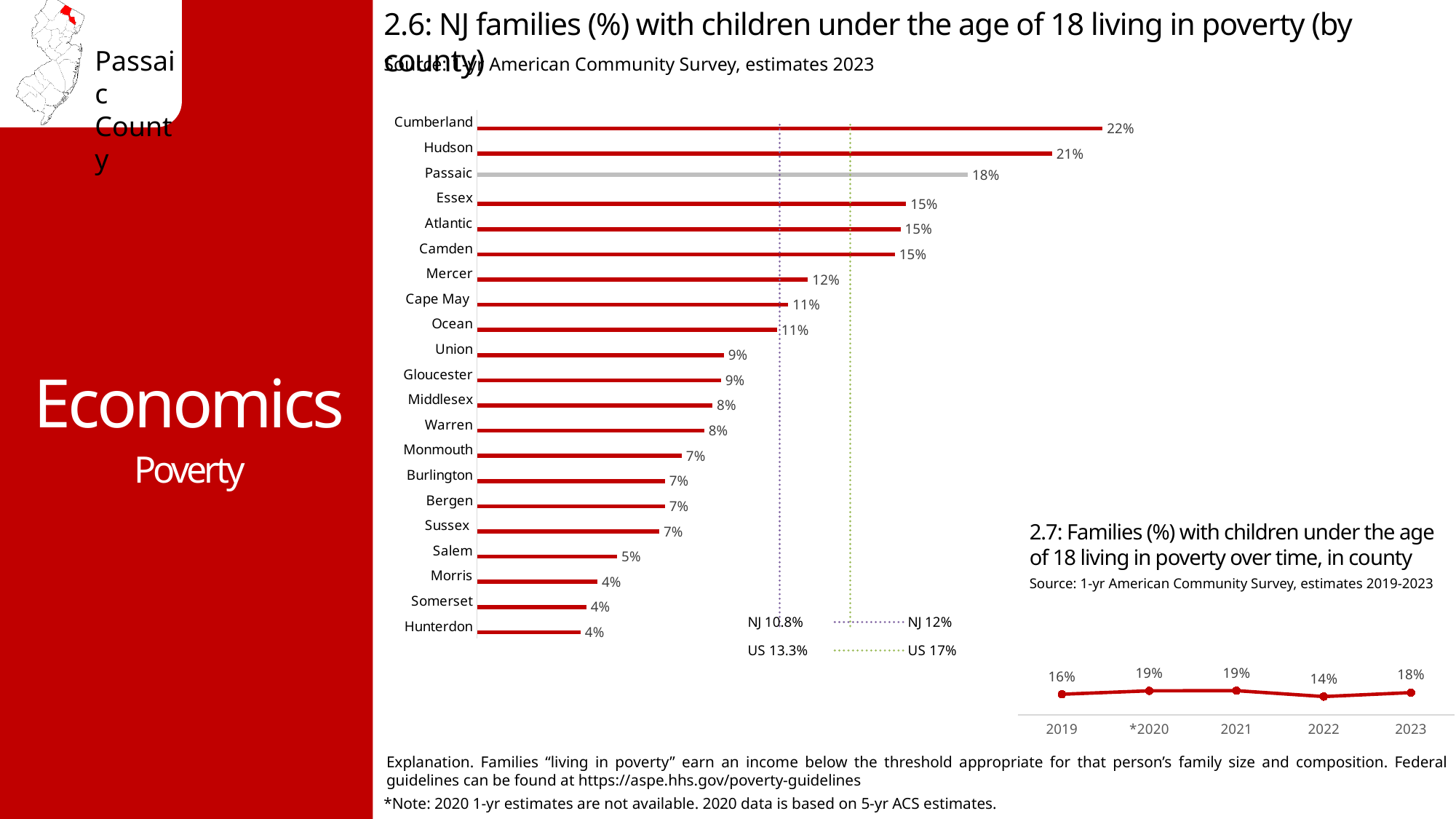
In chart 2.6, what is the difference between Cumberland and Hudson? 1% What kind of chart is chart 2.6? Bar chart In chart 2.7, what is the difference between the 2023 value and the 2022 value? 4% In chart 2.6, which is larger, the value for Essex or the value for Union? Essex In chart 2.6, what is the value for Mercer? 12% In chart 2.7, what is the value for 2022? 14% In chart 2.6, what is the value for Passaic? 18% In chart 2.7, which year has the lowest value? 2022 In chart 2.6, which county has the highest value? Cumberland What kind of chart is chart 2.7? Line chart In chart 2.6, how many counties are plotted? 21 In chart 2.6, what is the value for Salem? 5%